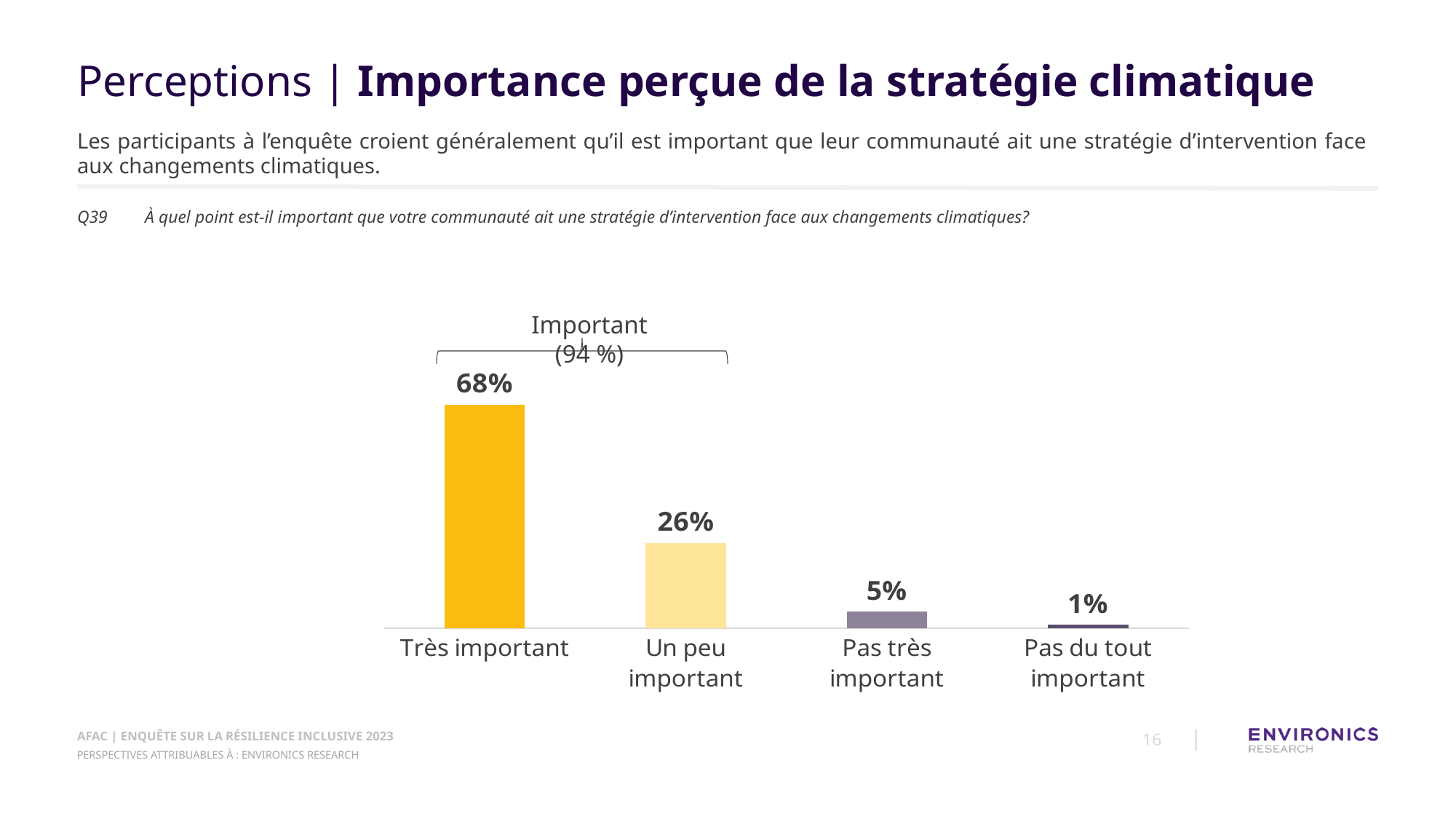
What percentage of respondents said it is 'Pas très important'? 5% Which category has the lowest value? Pas du tout important What kind of chart is shown on the slide? Bar chart What percentage of respondents said it is 'Un peu important'? 26% Which category has the highest value? Très important What combined percentage is shown by the bracket labelled 'Important' above the first two bars? 94 % What is the difference between the 'Très important' and 'Un peu important' values? 42% What percentage of respondents said it is 'Très important'? 68% How many categories are shown on the chart? 4 Do the values rise or fall from left to right across the categories? Fall Which is larger: 'Pas très important' or 'Pas du tout important'? Pas très important What percentage of respondents said it is 'Pas du tout important'? 1%